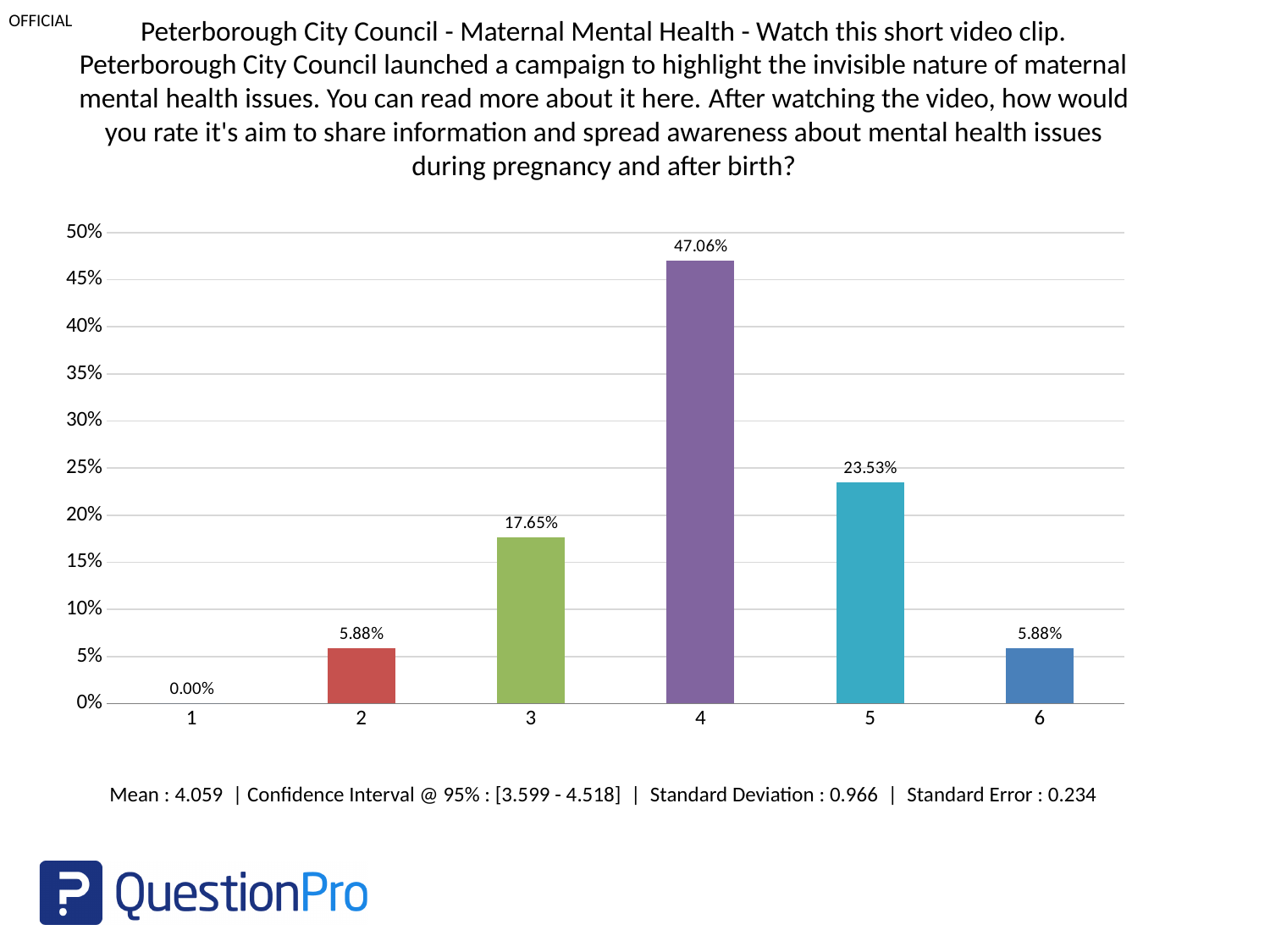
Which category has the lowest value? 1 Which category has the highest value? 4 What is the value for category 1? 0.00% Is the value for category 4 greater or less than 45%? greater Which is larger, the value for category 3 or the value for category 5? 5 How many categories are shown on the x axis? 6 What is the value for category 5? 23.53% What is the value for category 4? 47.06% What kind of chart is shown on the slide? bar chart What is the difference between the values for category 4 and category 5? 23.53% What is the value for category 3? 17.65% What mean value is reported below the chart? 4.059